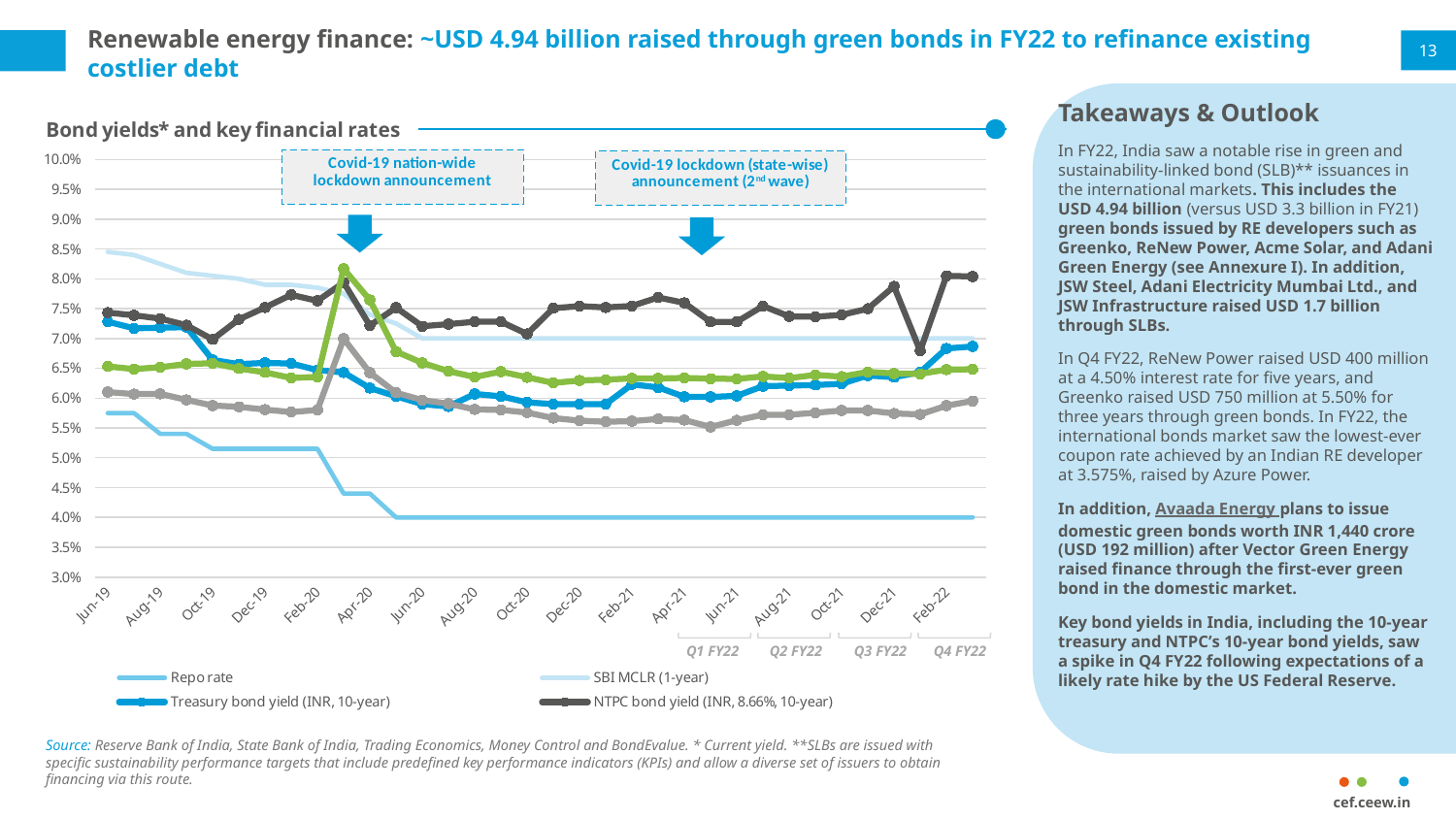
Is the Treasury bond yield (INR, 10-year) in Jun-19 greater or less than 7.0%? greater How many series does the chart legend list? 4 What is the title of the chart? Bond yields* and key financial rates Does the Repo rate rise or fall from Jun-19 to Jun-20? fall Is the Repo rate in Jun-19 greater or less than 6.0%? less Is the SBI MCLR (1-year) in Jun-19 greater or less than 8.0%? greater Which series has the lowest value in Feb-22? Repo rate In Feb-22, which is higher: the NTPC bond yield (INR, 8.66%, 10-year) or the Treasury bond yield (INR, 10-year)? NTPC bond yield (INR, 8.66%, 10-year) What kind of chart is shown on the slide? line chart Which series has the highest value in Jun-19? SBI MCLR (1-year) What is the Repo rate in Feb-22? 4.0%